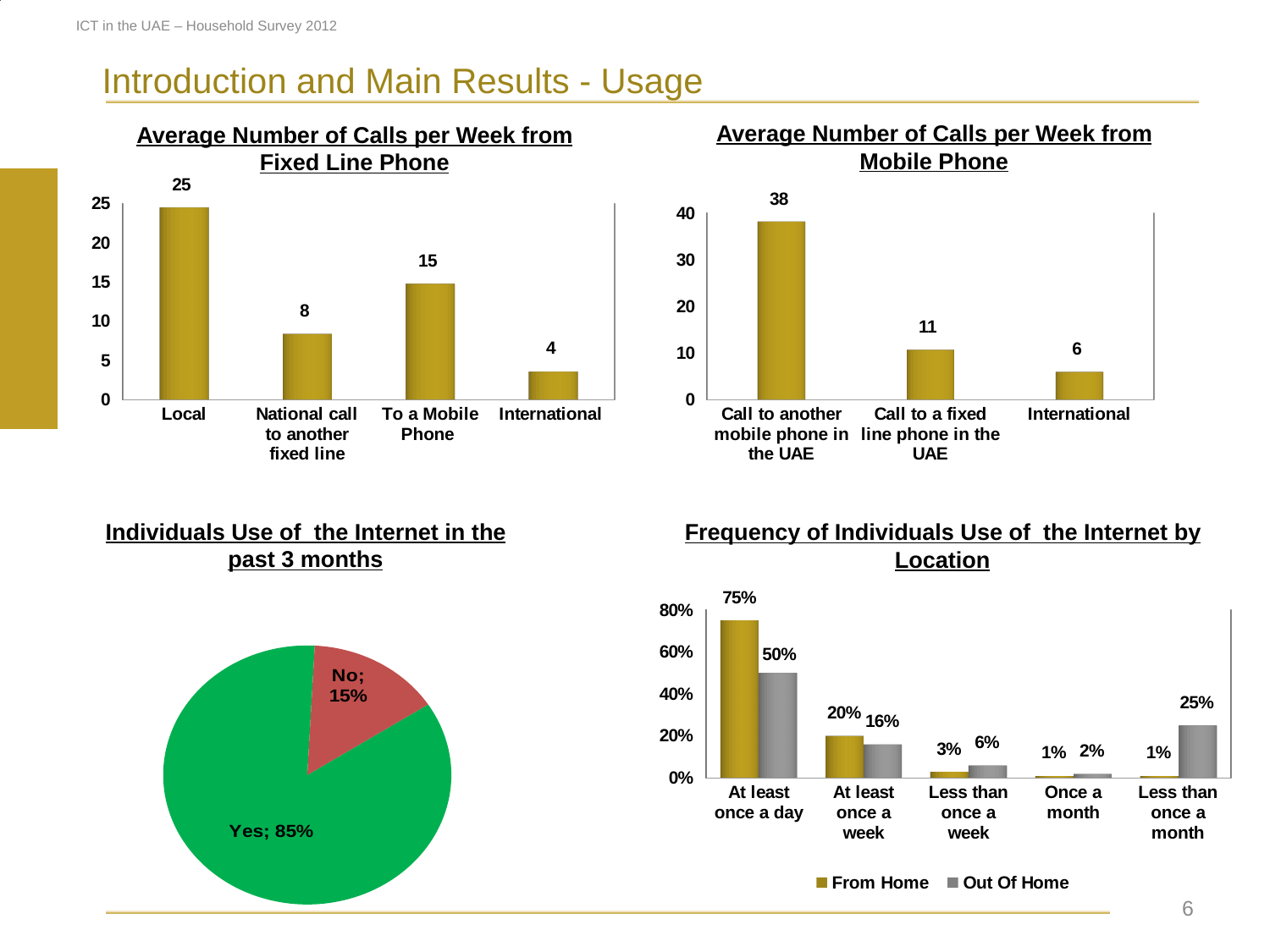
In the 'Average Number of Calls per Week from Fixed Line Phone' chart, which category has the lowest value? International In the 'Frequency of Individuals Use of the Internet by Location' chart, what is the difference between From Home and Out Of Home for At least once a day? 25% In the 'Average Number of Calls per Week from Mobile Phone' chart, which category has the highest value? Call to another mobile phone in the UAE In the 'Average Number of Calls per Week from Mobile Phone' chart, what is the value for Call to a fixed line phone in the UAE? 11 In the 'Average Number of Calls per Week from Fixed Line Phone' chart, what is the difference between Local and To a Mobile Phone? 10 How many series does the legend list in the 'Frequency of Individuals Use of the Internet by Location' chart? 2 In the 'Frequency of Individuals Use of the Internet by Location' chart, which is larger for Less than once a month: From Home or Out Of Home? Out Of Home In the 'Individuals Use of the Internet in the past 3 months' chart, what share of the pie is Yes? 85% In the 'Frequency of Individuals Use of the Internet by Location' chart, what is the From Home value for At least once a day? 75% What kind of chart is 'Individuals Use of the Internet in the past 3 months'? Pie chart How many categories are shown in the 'Average Number of Calls per Week from Mobile Phone' chart? 3 In the 'Average Number of Calls per Week from Fixed Line Phone' chart, what is the value for Local? 25